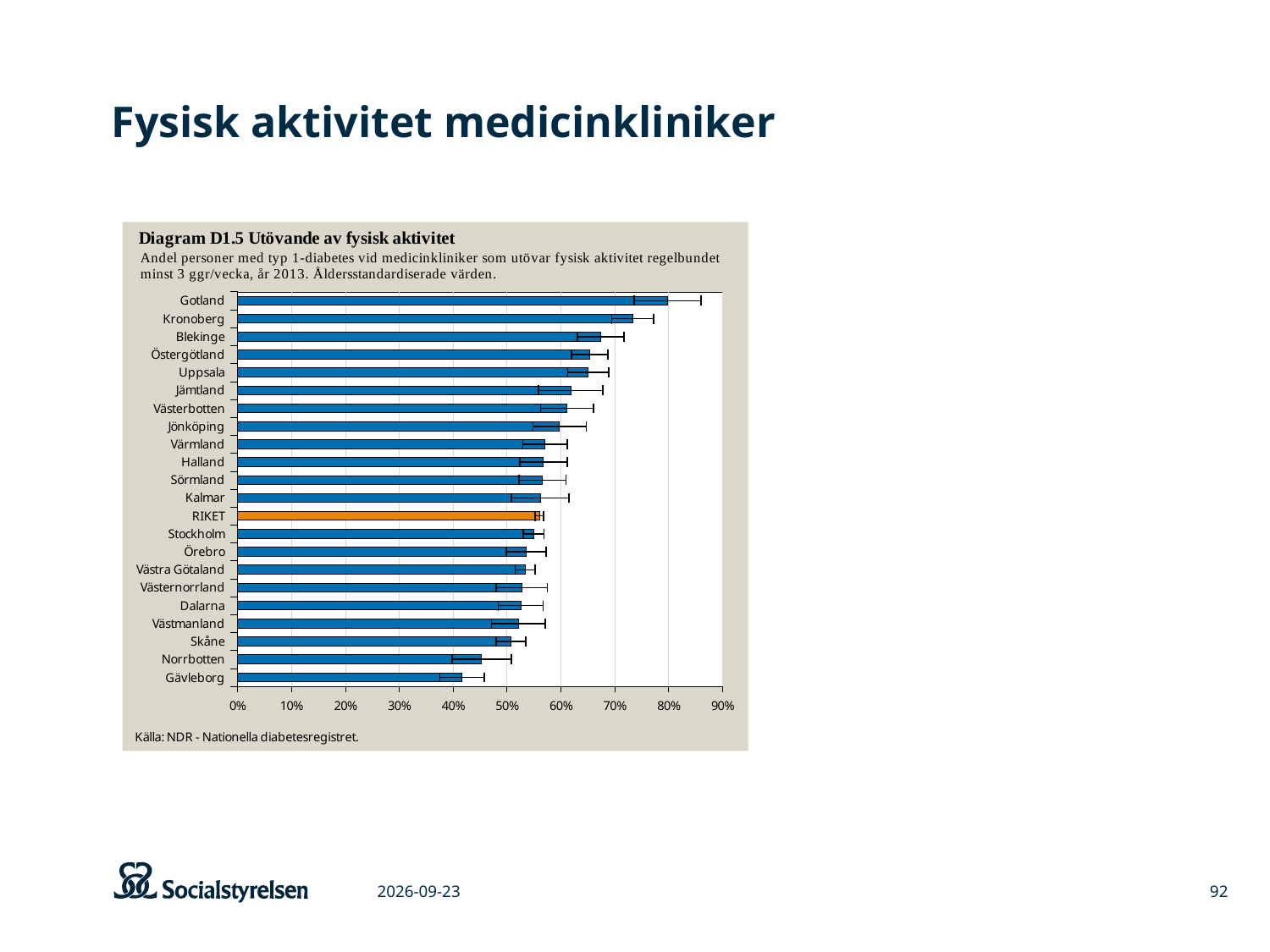
Which region has the highest share of physical activity in the chart? Gotland Which bar in the chart is coloured orange instead of blue? RIKET Is the value for Gotland greater or less than 70%? greater What kind of chart is shown on the slide? Bar chart Is the value for Gävleborg greater or less than 50%? less Is the value for Norrbotten greater or less than 50%? less How many bars (categories) are plotted in the chart? 22 Which has a higher value, Skåne or Blekinge? Blekinge Which has a higher value, Kronoberg or Norrbotten? Kronoberg Which region has the lowest share of physical activity in the chart? Gävleborg